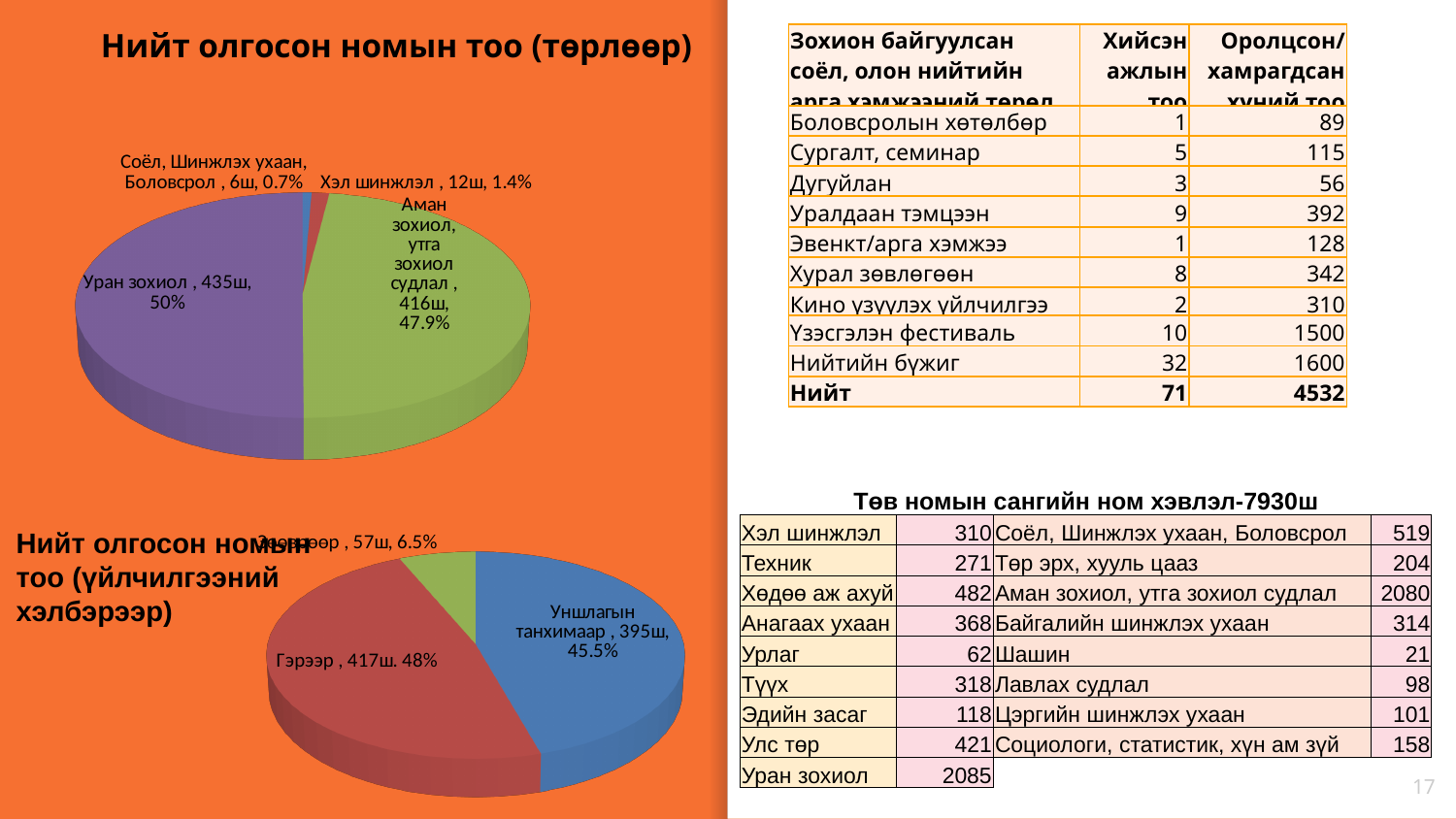
In the top pie chart titled "Нийт олгосон номын тоо (төрлөөр)", what is the value for Уран зохиол? 435ш In the top pie chart titled "Нийт олгосон номын тоо (төрлөөр)", how many slices does the pie have? 4 In the top pie chart titled "Нийт олгосон номын тоо (төрлөөр)", what is the difference between the values for Уран зохиол and Аман зохиол, утга зохиол судлал? 19ш In the bottom pie chart titled "Нийт олгосон номын тоо (үйлчилгээний хэлбэрээр)", what share of the pie does Уншлагын танхимаар have? 45.5% In the top pie chart titled "Нийт олгосон номын тоо (төрлөөр)", what share of the pie does Соёл, Шинжлэх ухаан, Боловсрол have? 0.7% In the bottom pie chart titled "Нийт олгосон номын тоо (үйлчилгээний хэлбэрээр)", what share of the pie does the smallest slice have? 6.5% In the bottom pie chart titled "Нийт олгосон номын тоо (үйлчилгээний хэлбэрээр)", which is larger, Гэрээр or Уншлагын танхимаар? Гэрээр What type of chart is the top chart titled "Нийт олгосон номын тоо (төрлөөр)"? Pie chart In the bottom pie chart titled "Нийт олгосон номын тоо (үйлчилгээний хэлбэрээр)", what is the value for Гэрээр? 417ш In the top pie chart titled "Нийт олгосон номын тоо (төрлөөр)", which category has the smallest slice? Соёл, Шинжлэх ухаан, Боловсрол In the top pie chart titled "Нийт олгосон номын тоо (төрлөөр)", what is the value for Хэл шинжлэл? 12ш